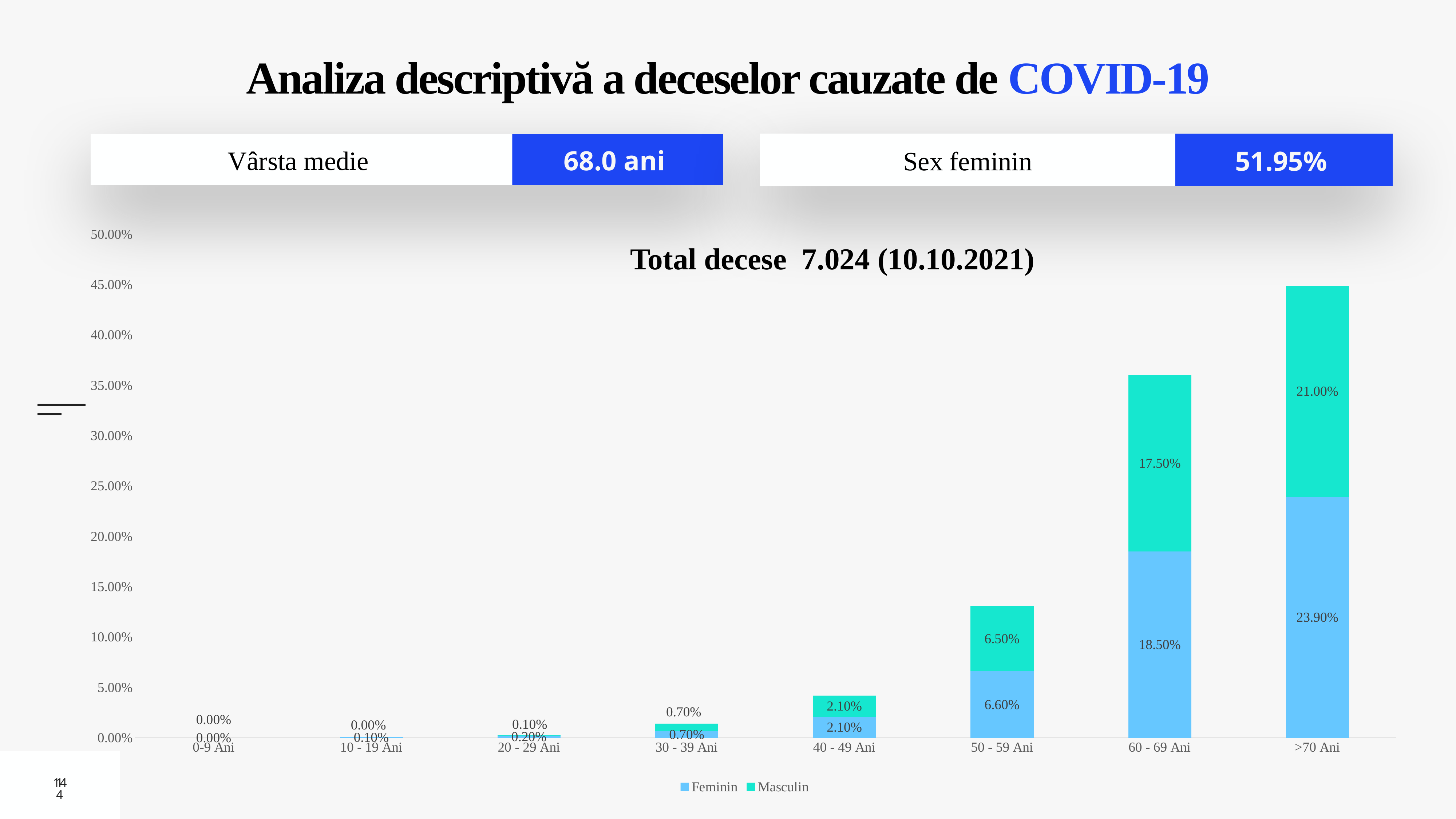
What kind of chart is shown on the slide? Stacked bar chart What is the Masculin value for the 40 - 49 Ani age group? 2.10% What is the total of the stacked bar for the 60 - 69 Ani age group? 36.00% How many age groups are shown on the x axis? 8 Which age group has the highest Feminin value? >70 Ani What is the Feminin value for the >70 Ani age group? 23.90% Which is larger, the Masculin value for 50 - 59 Ani or the Masculin value for 60 - 69 Ani? 60 - 69 Ani Do the stacked bar totals rise or fall as age increases along the x axis? Rise What is the difference between the Feminin and Masculin values for the >70 Ani age group? 2.90% What is the Feminin value for the 50 - 59 Ani age group? 6.60% How many series does the legend list? 2 What is the Masculin value for the 60 - 69 Ani age group? 17.50%